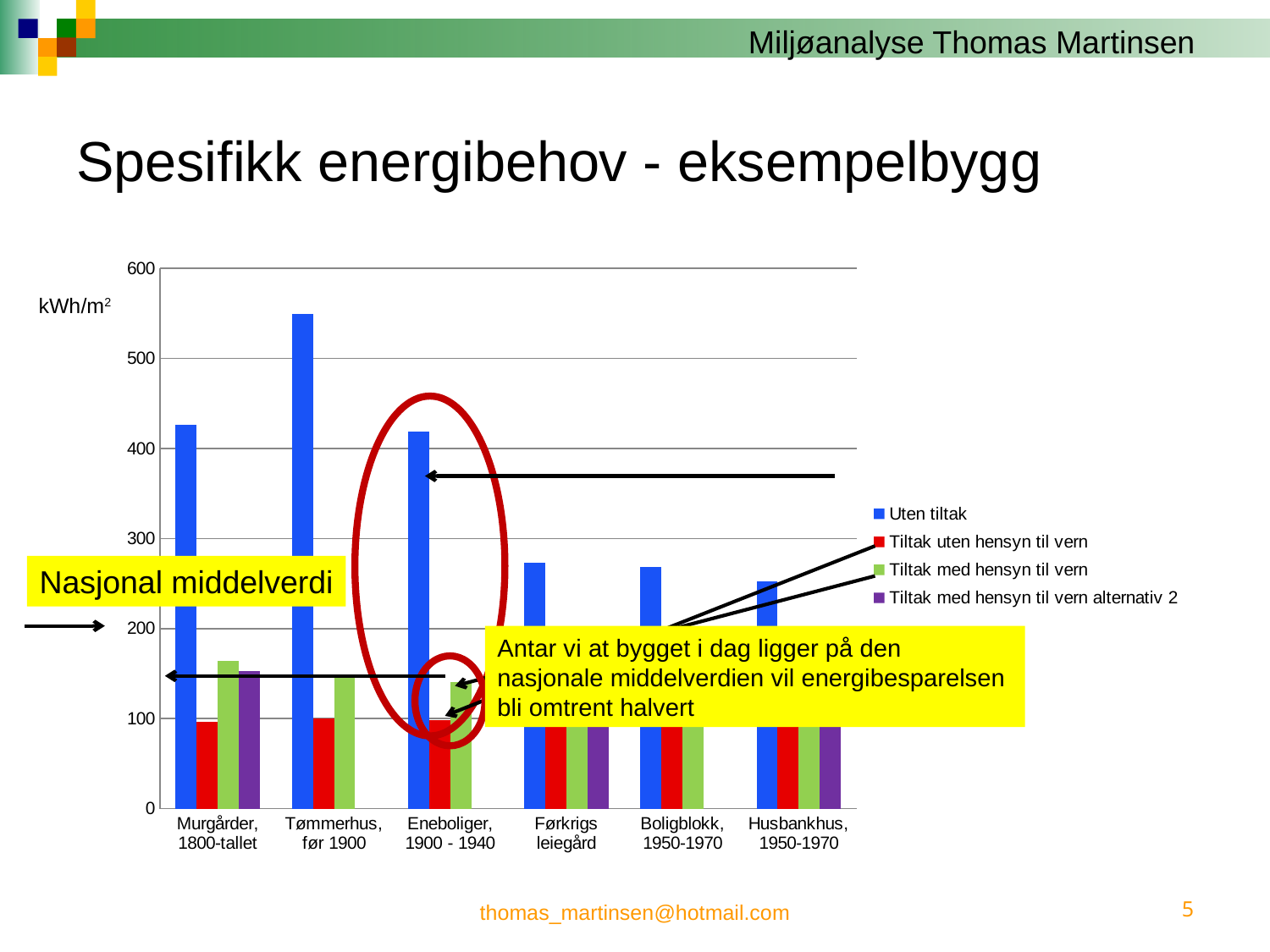
Is the 'Uten tiltak' value for Tømmerhus, før 1900 greater or less than 500? greater Is the 'Uten tiltak' value for Husbankhus, 1950-1970 greater or less than 300? less Is the 'Uten tiltak' value for Førkrigs leiegård greater or less than 300? less What unit is shown on the y axis of the chart? kWh/m² How many series does the legend list? 4 How many building categories are shown on the x axis? 6 Which series is shown in blue according to the legend? Uten tiltak Which has the larger 'Uten tiltak' value: Murgårder, 1800-tallet or Boligblokk, 1950-1970? Murgårder, 1800-tallet What kind of chart is shown on the slide? bar chart Which category has the highest value for the 'Uten tiltak' series? Tømmerhus, før 1900 Which has the larger 'Uten tiltak' value: Tømmerhus, før 1900 or Murgårder, 1800-tallet? Tømmerhus, før 1900